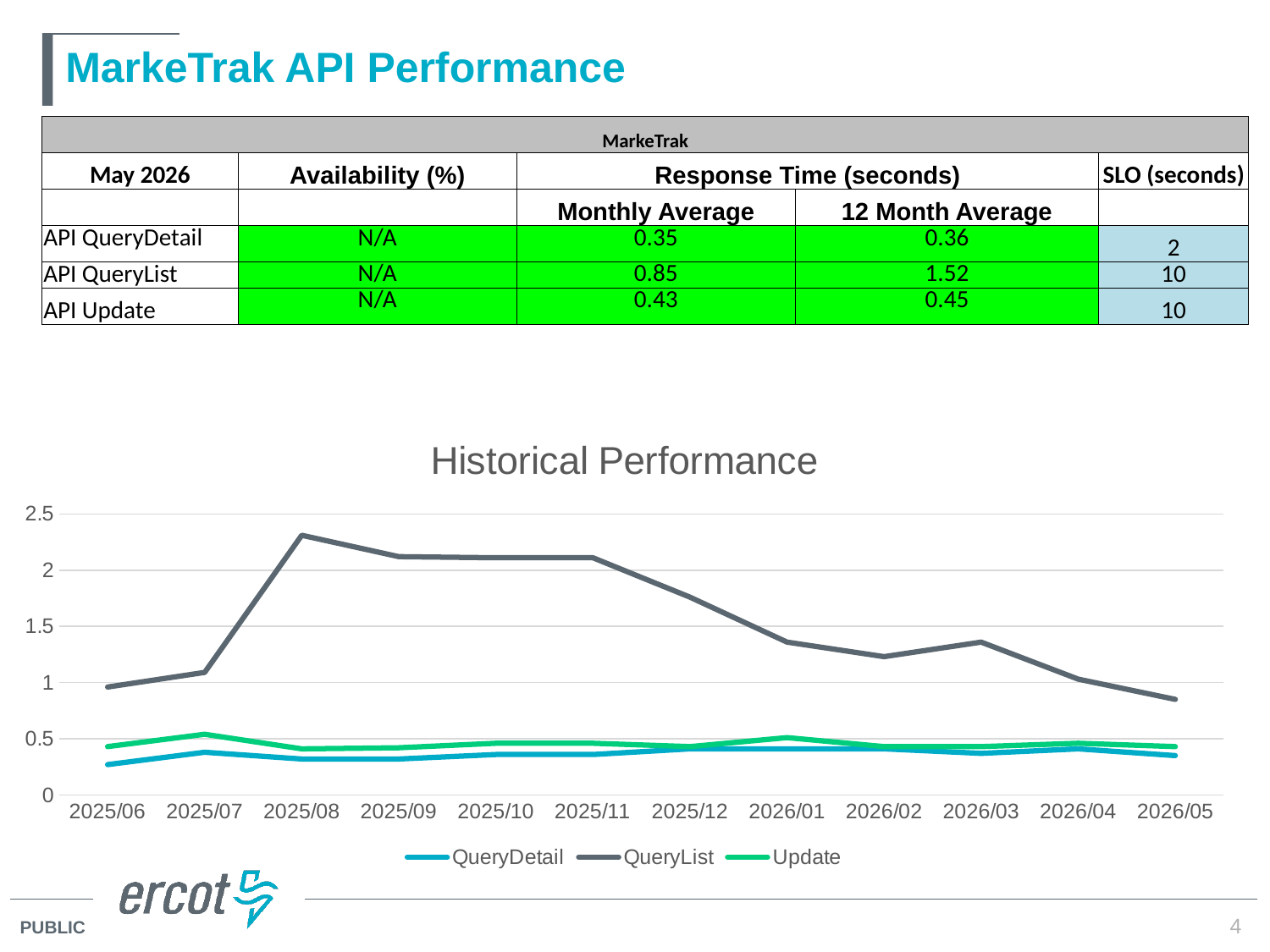
How many series does the legend of the Historical Performance chart list? 3 In which month is the QueryList series lowest in the Historical Performance chart? 2026/05 Is the QueryDetail value for 2025/06 greater or less than 0.5? less Which series reaches the highest value in the Historical Performance chart? QueryList Is the QueryList value for 2026/01 greater or less than 1.5? less At 2025/08, which series has the larger value, QueryList or QueryDetail? QueryList Does the QueryList series rise or fall from 2025/08 to 2025/12? fall Is the QueryList value for 2026/05 greater or less than 1? less What kind of chart is the Historical Performance chart? line chart In which month does the QueryList series peak in the Historical Performance chart? 2025/08 How many months are shown on the x axis of the Historical Performance chart? 12